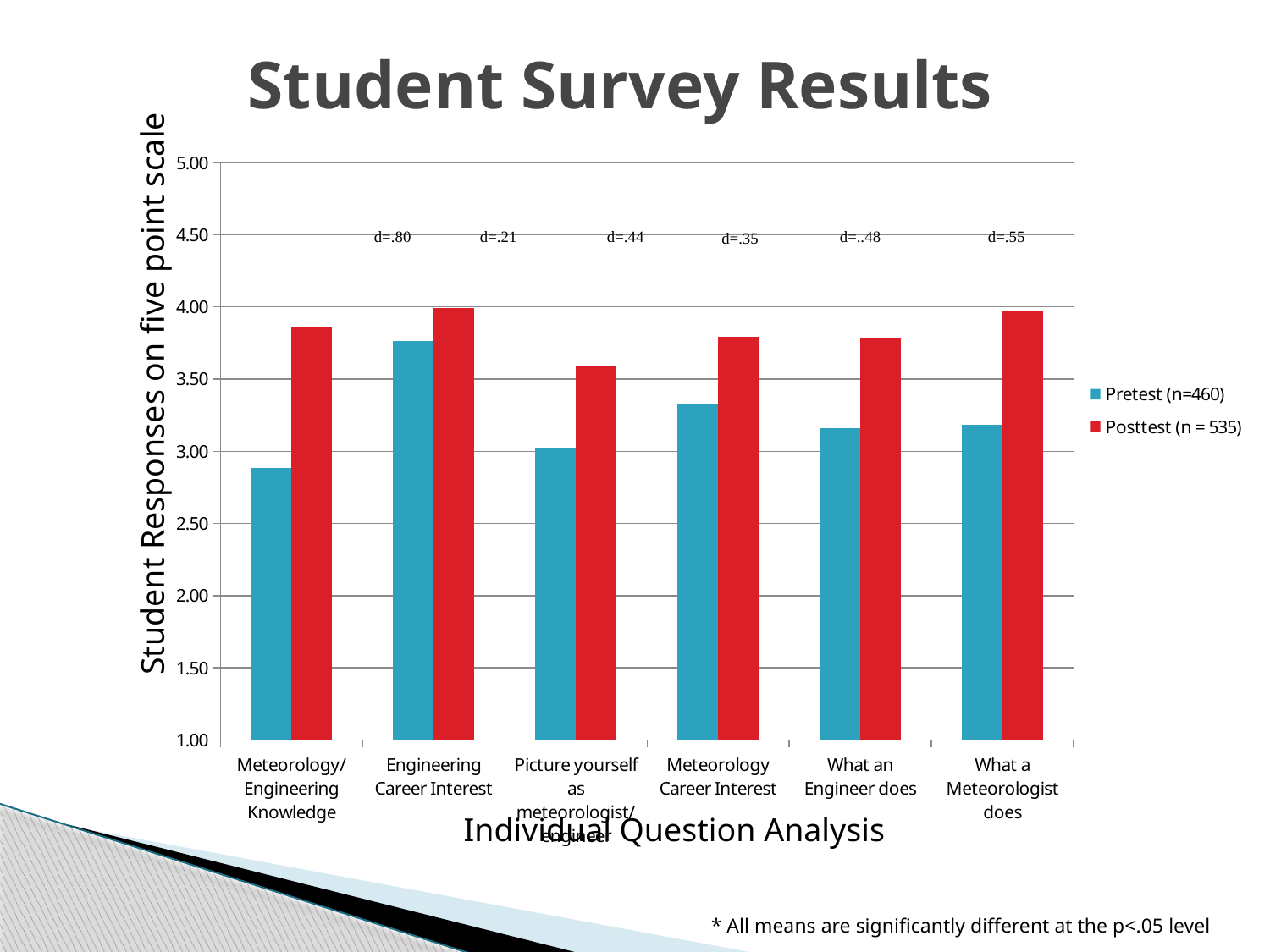
Which category has the highest Pretest (n=460) value? Engineering Career Interest Is the Posttest (n = 535) value for Meteorology Career Interest greater or less than 4.00? less How many question categories are shown on the x axis? 6 What effect size (d) is printed above the Meteorology/Engineering Knowledge bars? d=.80 Which category has the lowest Posttest (n = 535) value? Picture yourself as meteorologist/engineer How many series does the legend list? 2 Which category has the lowest Pretest (n=460) value? Meteorology/Engineering Knowledge Which is larger: the Pretest (n=460) value for Engineering Career Interest or the Pretest (n=460) value for Meteorology Career Interest? Engineering Career Interest Is the Pretest (n=460) value for Meteorology/Engineering Knowledge greater or less than 3.00? less What kind of chart is shown on the slide? bar chart For What an Engineer does, which is larger: the Pretest (n=460) value or the Posttest (n = 535) value? Posttest (n = 535) Is the Posttest (n = 535) value for Picture yourself as meteorologist/engineer greater or less than 3.50? greater